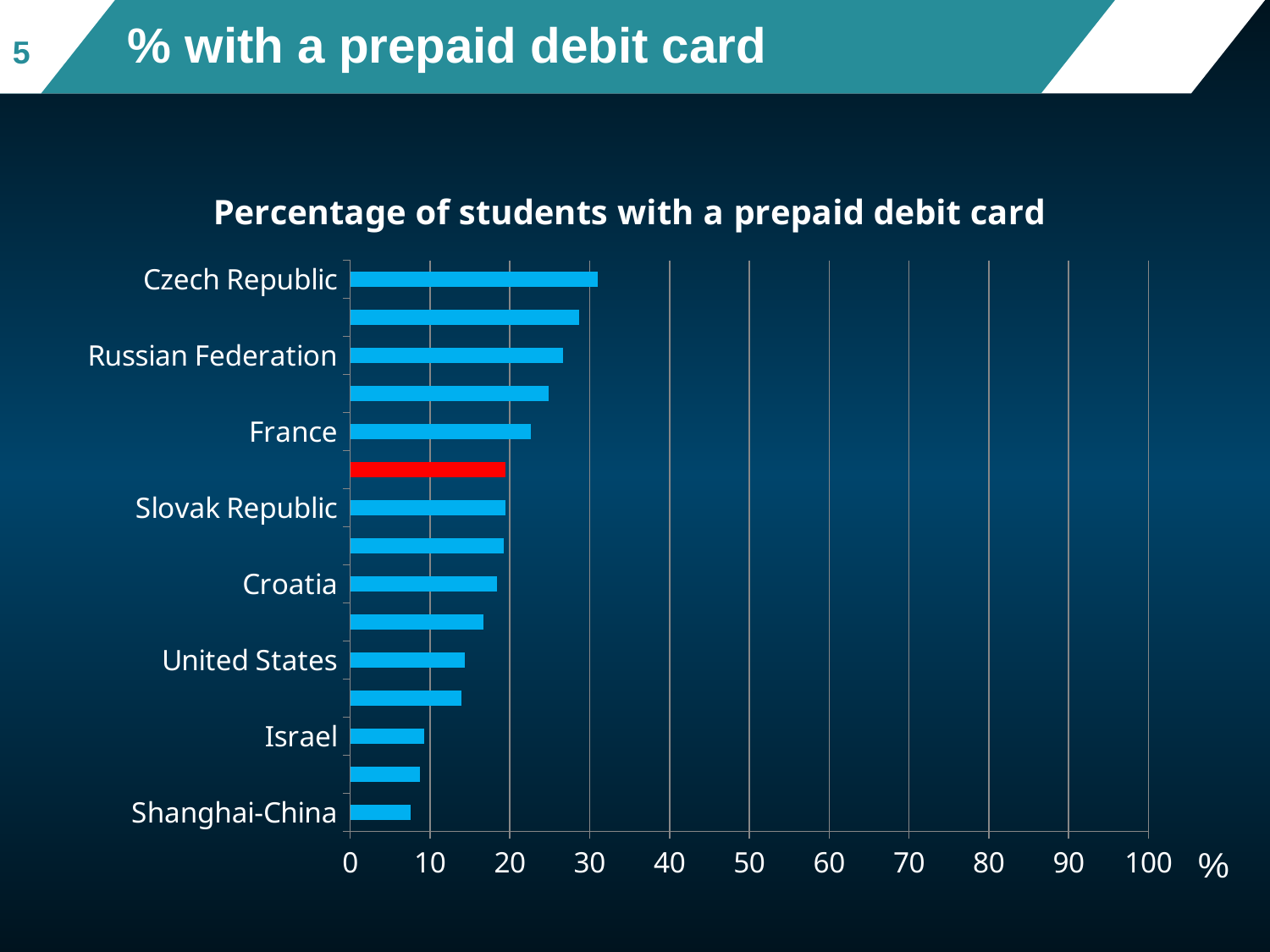
Is the value for Russian Federation greater or less than 30? less Which labelled country has the lowest percentage of students with a prepaid debit card? Shanghai-China Which labelled country has the highest percentage of students with a prepaid debit card? Czech Republic How many bars are plotted in the chart? 15 Is the value for Czech Republic greater or less than 20? greater Is the value for United States greater or less than 20? less Which has a higher value, France or United States? France What is the title of the chart? Percentage of students with a prepaid debit card Which has a higher value, Czech Republic or Israel? Czech Republic Do the bar values increase or decrease going from the top of the chart to the bottom? decrease What kind of chart is shown on the slide? bar chart